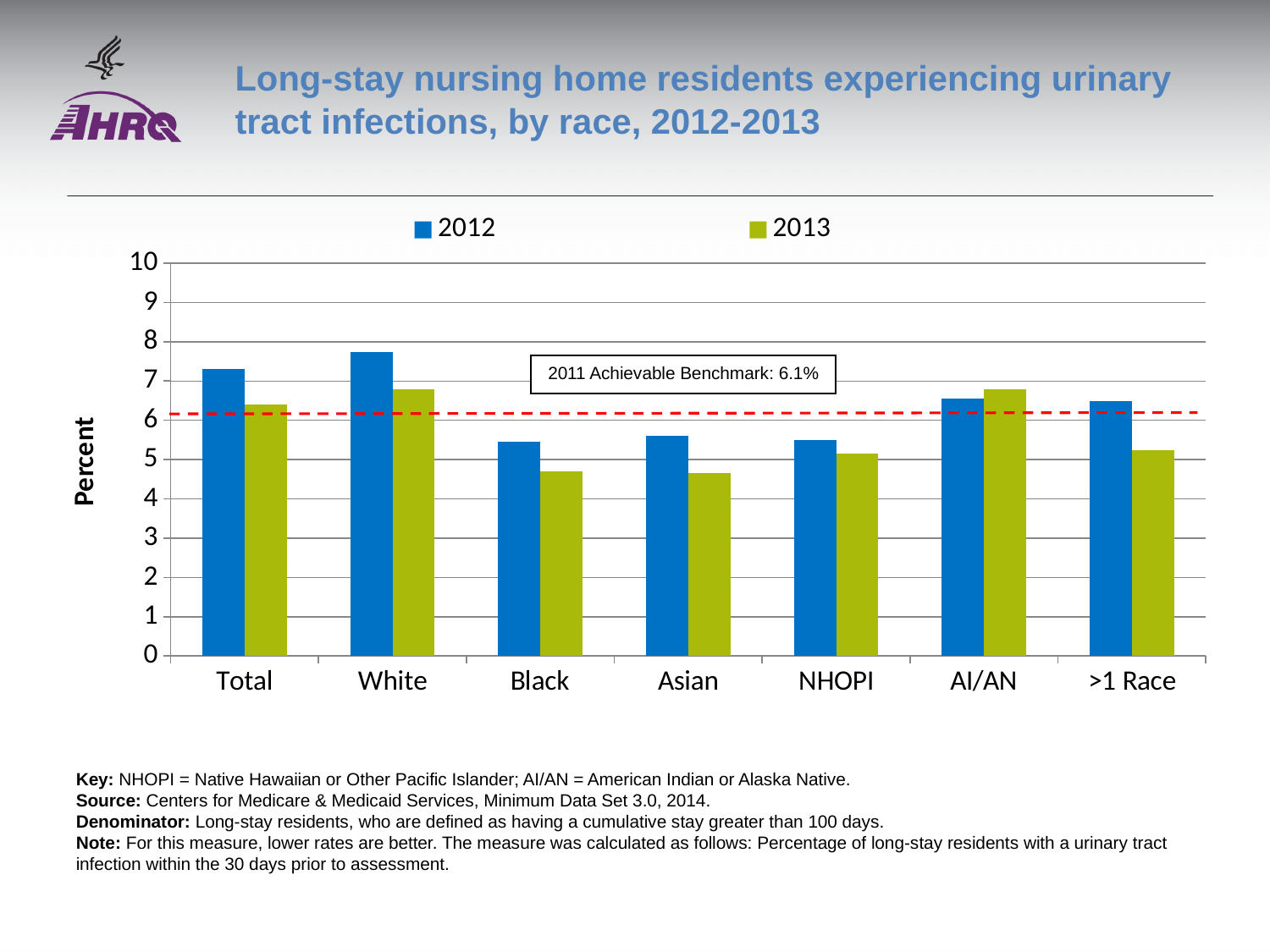
Is the 2013 value for >1 Race greater or less than 6? less What is the 2011 achievable benchmark shown on the chart? 6.1% Is the 2013 value for Black greater or less than 5? less For AI/AN, which year has the larger value, 2012 or 2013? 2013 What kind of chart is shown on the slide? Bar chart Is the 2012 value for White greater or less than 7? greater What is the label of the y axis? Percent How many series does the legend list? 2 For Total, which year has the larger value, 2012 or 2013? 2012 Which race category has the highest 2012 value? White How many race categories are shown on the x axis? 7